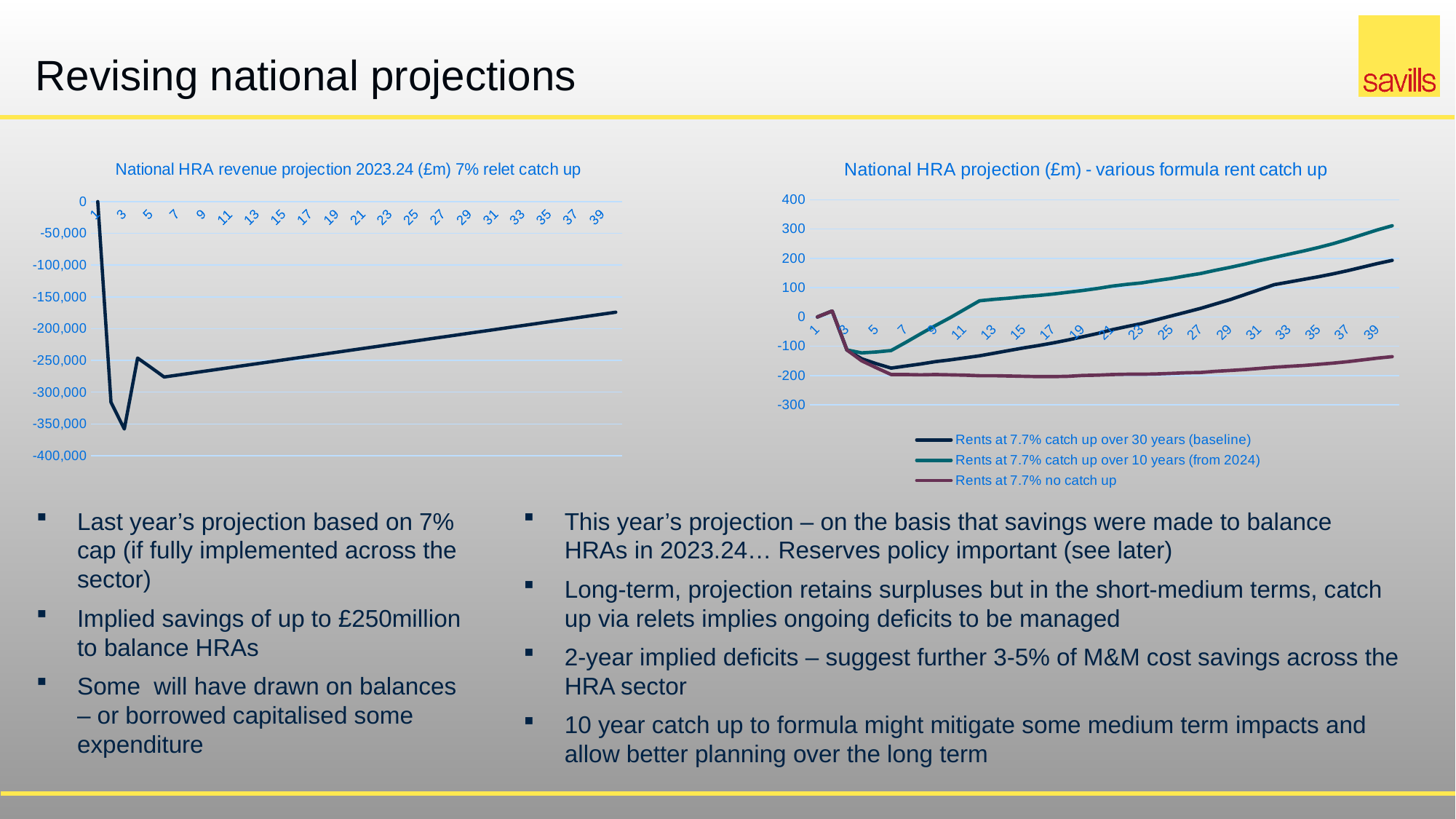
What kind of chart is the right chart, 'National HRA projection (£m) - various formula rent catch up'? line chart In the left chart, is the value at point 39 greater or less than -200,000? greater In the left chart, is the value at point 3 greater or less than -300,000? less In the right chart, which series is highest at point 39? Rents at 7.7% catch up over 10 years (from 2024) In the left chart, does the line rise or fall from point 7 to point 39? rise In the right chart, at point 39, which is larger: the 'Rents at 7.7% catch up over 10 years (from 2024)' series or the 'Rents at 7.7% catch up over 30 years (baseline)' series? Rents at 7.7% catch up over 10 years (from 2024) In the right chart, is the value of the 'Rents at 7.7% no catch up' series at point 39 greater or less than -100? less In the right chart, which series is lowest at point 39? Rents at 7.7% no catch up What kind of chart is the left chart, 'National HRA revenue projection 2023.24 (£m) 7% relet catch up'? line chart In the right chart, how many series does the legend list? 3 What is the title of the right chart? National HRA projection (£m) - various formula rent catch up